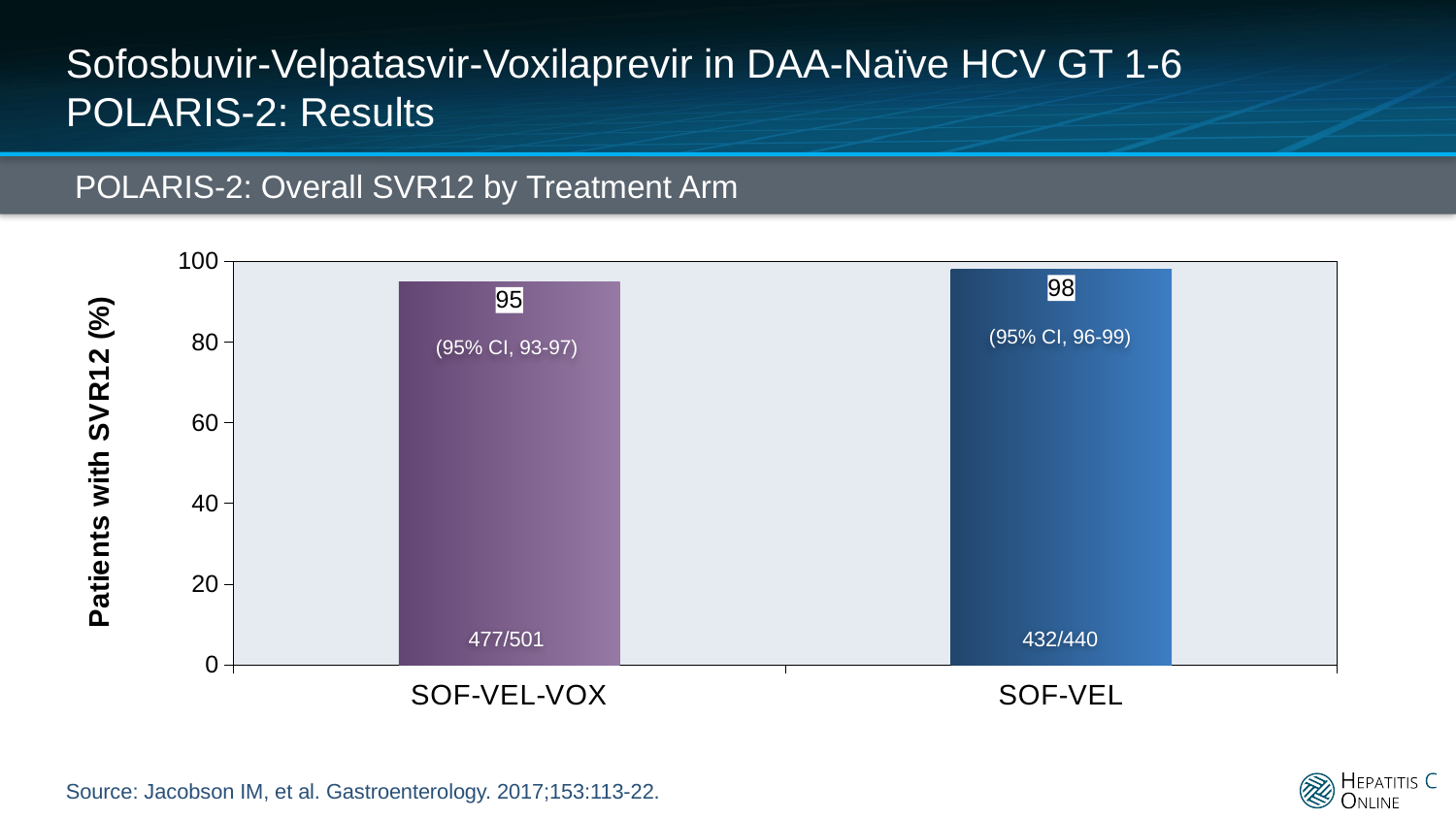
Which treatment arm has the lower SVR12 rate? SOF-VEL-VOX What is the 95% confidence interval shown for the SOF-VEL-VOX arm? 93-97 What is the difference in SVR12 rate between SOF-VEL and SOF-VEL-VOX? 3 What is the SVR12 rate for the SOF-VEL-VOX arm? 95 How many patients achieved SVR12 out of the total in the SOF-VEL-VOX arm? 477/501 What is the 95% confidence interval shown for the SOF-VEL arm? 96-99 Is the SVR12 rate for SOF-VEL-VOX greater or less than 80? greater What is the SVR12 rate for the SOF-VEL arm? 98 What is the label of the y-axis? Patients with SVR12 (%) Which treatment arm has the higher SVR12 rate? SOF-VEL How many treatment arms are shown in the chart? 2 What kind of chart is shown on the slide? bar chart